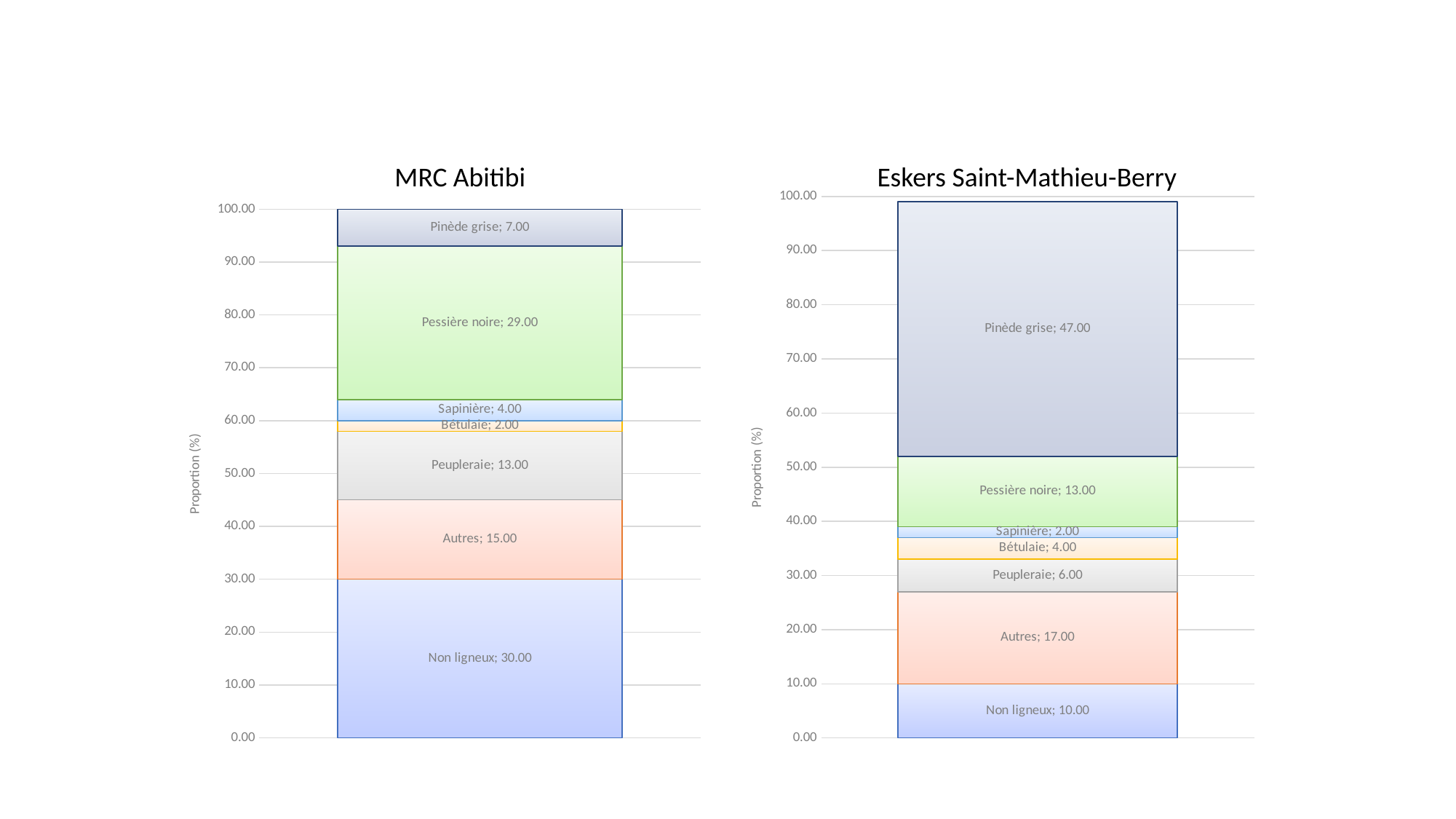
In the MRC Abitibi chart, what is the value for Non ligneux? 30.00 In the MRC Abitibi chart, what is the difference between the Autres and Peupleraie values? 2.00 In the Eskers Saint-Mathieu-Berry chart, which is larger, Autres or Pessière noire? Autres What is the y-axis label on the Eskers Saint-Mathieu-Berry chart? Proportion (%) In the MRC Abitibi chart, what is the value for Pessière noire? 29.00 How many segments make up the stacked bar in the MRC Abitibi chart? 7 In the MRC Abitibi chart, which segment has the largest value? Non ligneux What is the total of the stacked bar in the Eskers Saint-Mathieu-Berry chart? 99.00 In the Eskers Saint-Mathieu-Berry chart, what is the value for Peupleraie? 6.00 In the Eskers Saint-Mathieu-Berry chart, what is the value for Pinède grise? 47.00 In the Eskers Saint-Mathieu-Berry chart, which segment has the smallest value? Sapinière What type of chart is the MRC Abitibi chart? Stacked bar chart